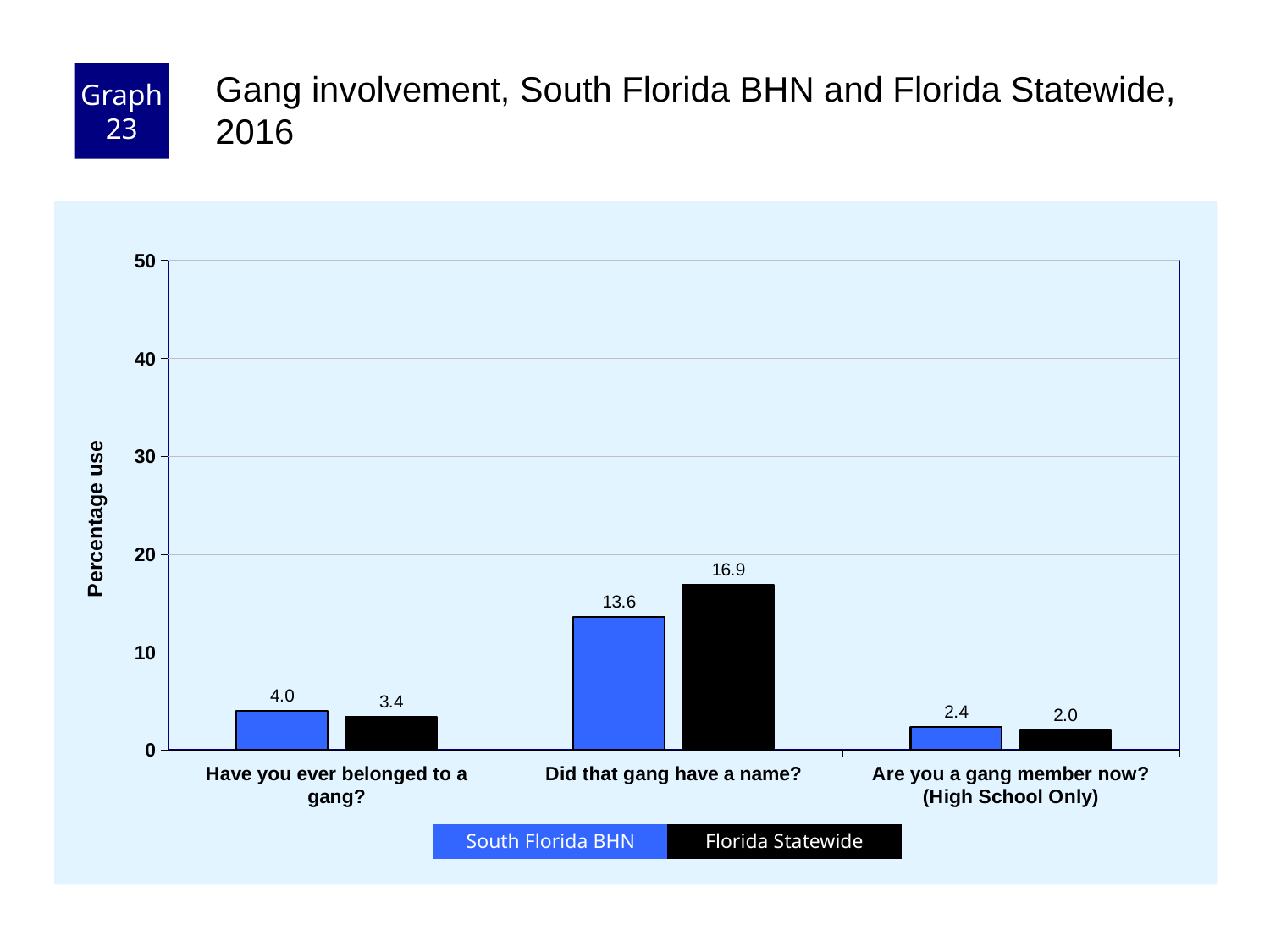
What kind of chart is shown on the slide? Bar chart What is the difference between the Florida Statewide and South Florida BHN values for "Did that gang have a name?"? 3.3 How many question categories are shown on the x axis? 3 Is the South Florida BHN value for "Did that gang have a name?" greater or less than 10? greater What is the label of the y axis? Percentage use Which question category has the highest South Florida BHN value? Did that gang have a name? Which question category has the lowest Florida Statewide value? Are you a gang member now? (High School Only) What is the South Florida BHN value for "Have you ever belonged to a gang?"? 4.0 What is the Florida Statewide value for "Did that gang have a name?"? 16.9 For "Have you ever belonged to a gang?", which is larger: South Florida BHN or Florida Statewide? South Florida BHN How many series does the legend list? 2 What is the Florida Statewide value for "Are you a gang member now? (High School Only)"? 2.0